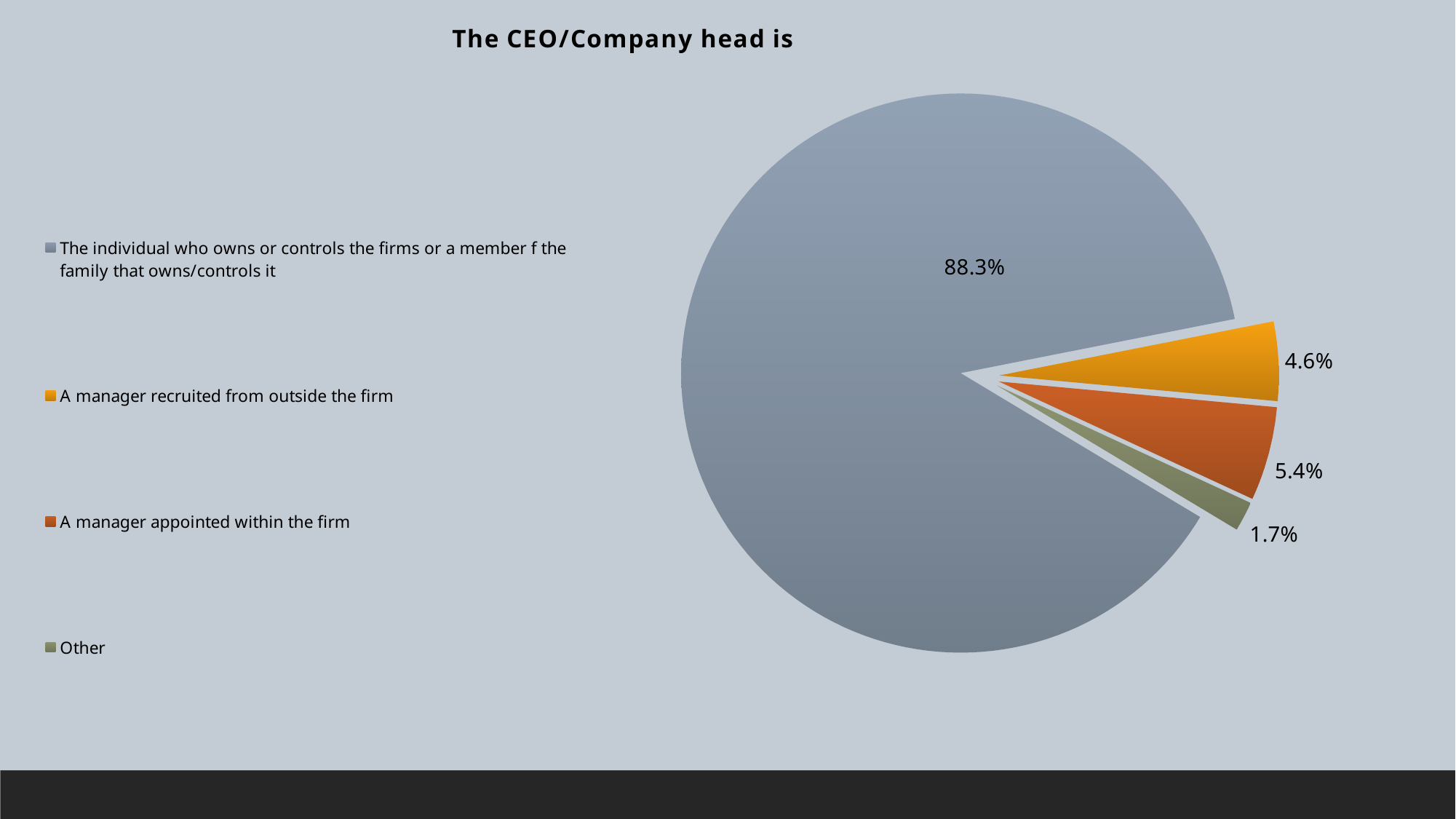
What share of the pie is 'Other'? 1.7% Which category has the largest slice of the pie? The individual who owns or controls the firms or a member f the family that owns/controls it What share of the pie is 'A manager recruited from outside the firm'? 4.6% Which is larger: 'A manager appointed within the firm' or 'A manager recruited from outside the firm'? A manager appointed within the firm Which category has the smallest slice of the pie? Other What kind of chart is shown on the slide? pie chart What colour is the slice for 'A manager recruited from outside the firm'? orange/yellow What share of the pie is 'The individual who owns or controls the firms or a member f the family that owns/controls it'? 88.3% How many slices does the pie chart have? 4 What is the title of the chart? The CEO/Company head is What is the difference between the shares for 'A manager appointed within the firm' and 'A manager recruited from outside the firm'? 0.8%